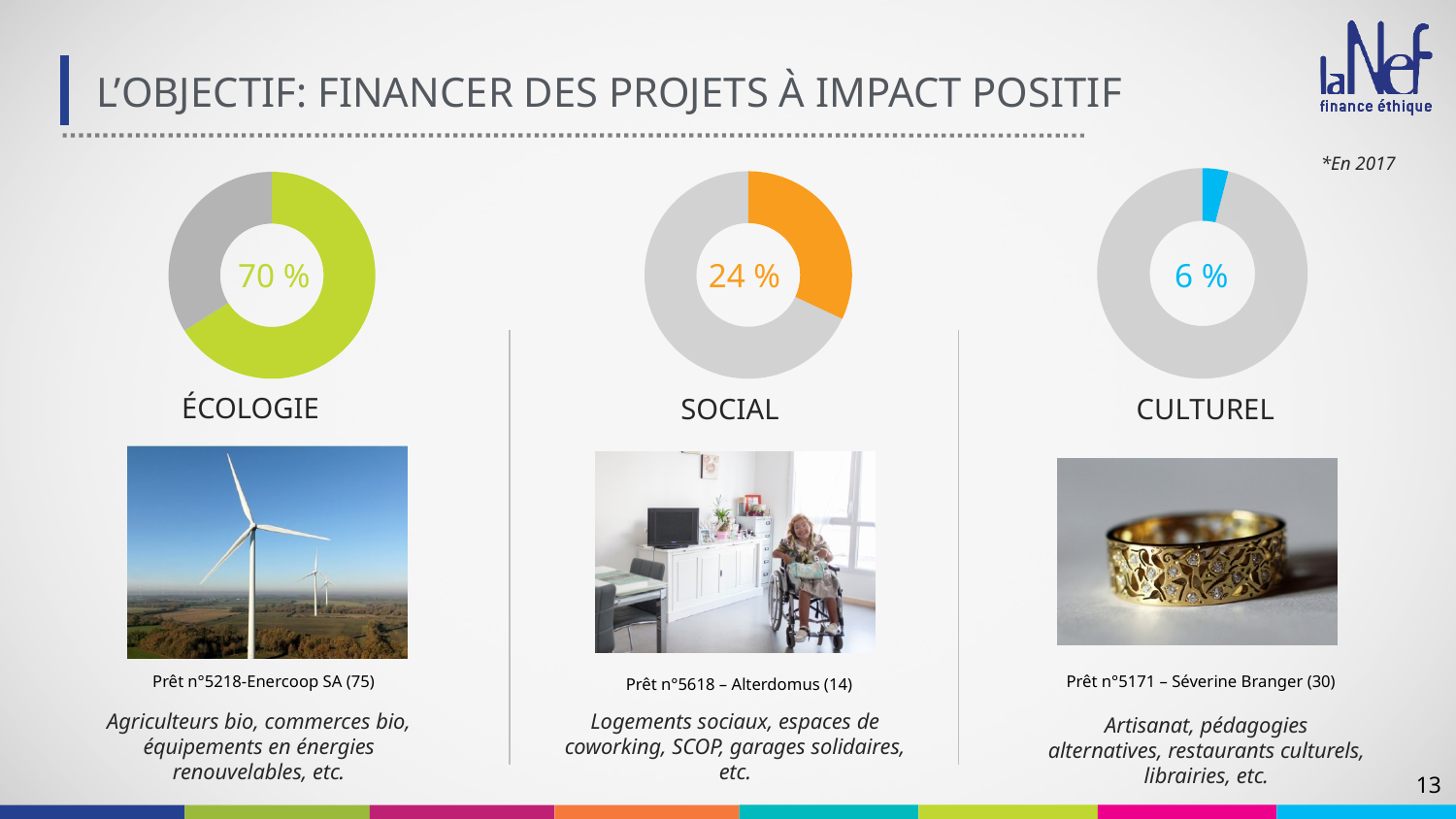
What is the sum of the three percentages shown in the ÉCOLOGIE, SOCIAL and CULTUREL charts? 100 % What colour is the highlighted segment in the SOCIAL donut chart? Orange What type of chart is used to show the ÉCOLOGIE, SOCIAL and CULTUREL percentages? Donut chart How many donut charts are shown on the slide? 3 Which of the three categories (ÉCOLOGIE, SOCIAL, CULTUREL) has the lowest percentage? CULTUREL What percentage is shown in the CULTUREL donut chart? 6 % What percentage is shown in the ÉCOLOGIE donut chart? 70 % Which is larger, the SOCIAL percentage or the CULTUREL percentage? SOCIAL What is the difference in percentage points between the SOCIAL chart and the CULTUREL chart? 18 Which of the three categories (ÉCOLOGIE, SOCIAL, CULTUREL) has the highest percentage? ÉCOLOGIE What percentage is shown in the SOCIAL donut chart? 24 % What is the difference in percentage points between the ÉCOLOGIE chart and the SOCIAL chart? 46